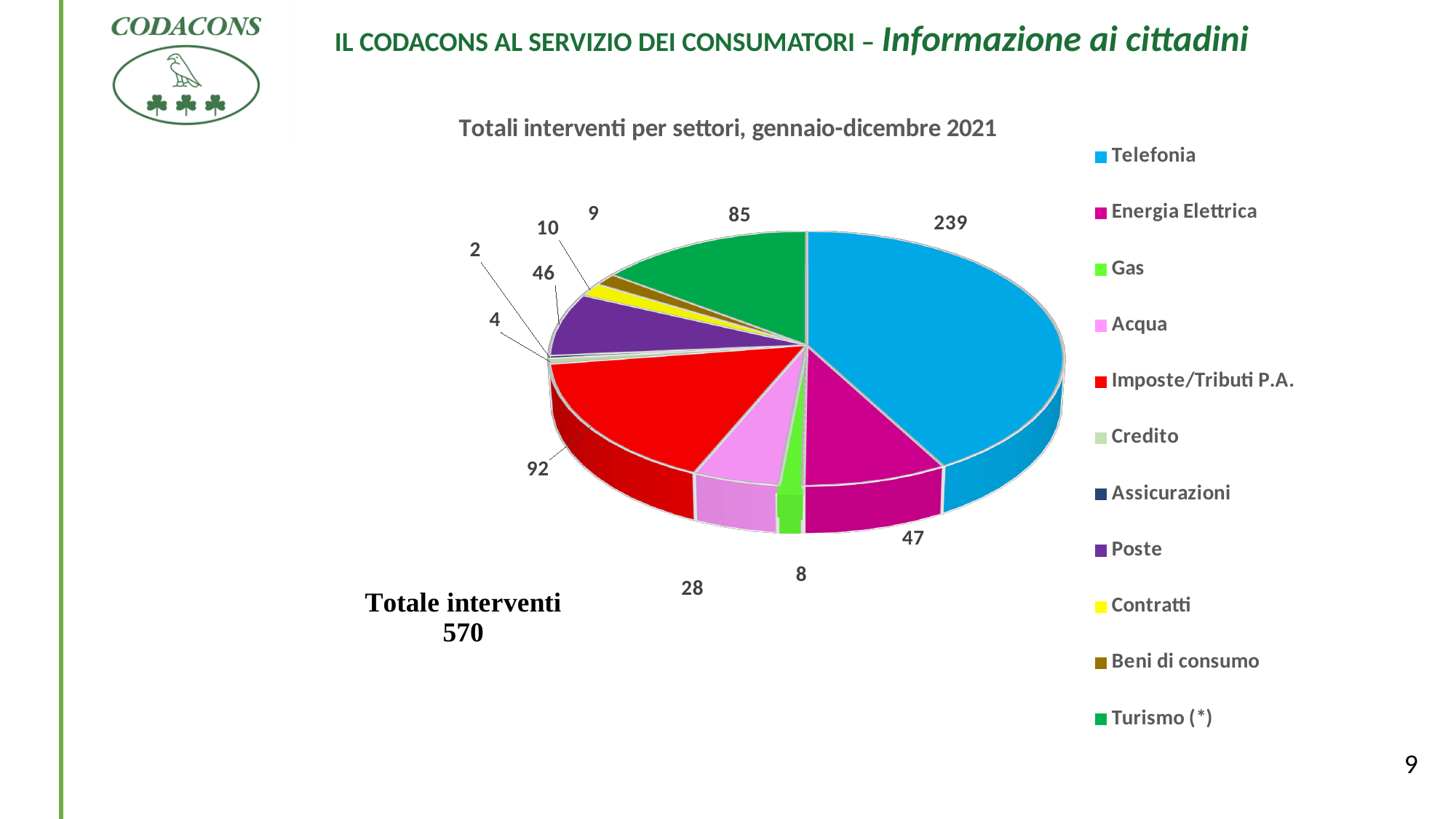
What is the value for Turismo (*)? 85 What is the value for Gas? 8 Which sector has the smallest value in the chart? Assicurazioni How many interventions are shown for Imposte/Tributi P.A.? 92 What kind of chart is shown on the slide? Pie chart How many sectors are listed in the chart legend? 11 What is the difference between the values for Telefonia and Imposte/Tributi P.A.? 147 Which sector has the largest slice of the pie? Telefonia What is the title of the chart? Totali interventi per settori, gennaio-dicembre 2021 What is the value for Telefonia in the pie chart? 239 What is the total number of interventions shown on the slide? 570 Which is larger, the value for Poste or the value for Acqua? Poste